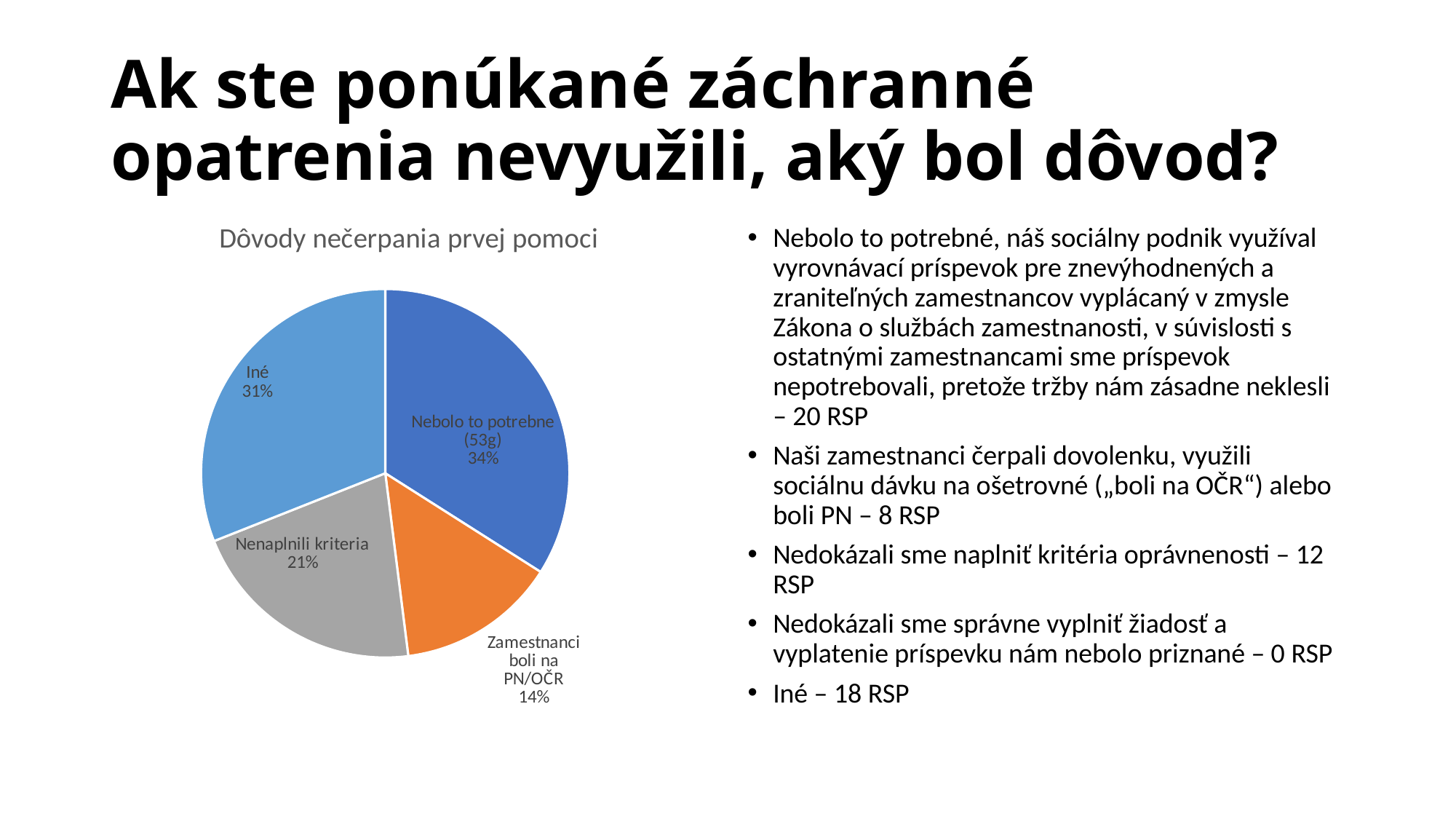
How many slices does the pie chart have? 4 Which slice of the pie chart is the largest? Nebolo to potrebne (53g) What type of chart is shown on the slide? pie chart What percentage is shown for the slice 'Nenaplnili kriteria'? 21% Which slice of the pie chart is the smallest? Zamestnanci boli na PN/OČR What is the difference in percentage points between the 'Iné' slice and the 'Nenaplnili kriteria' slice? 10 Which slice is larger: 'Iné' or 'Nenaplnili kriteria'? Iné What percentage is shown for the slice 'Zamestnanci boli na PN/OČR'? 14% What share of the pie does the slice 'Nebolo to potrebne (53g)' represent? 34% What percentage is shown for the slice 'Iné'? 31% What colour is the 'Nenaplnili kriteria' slice? grey What is the title of the chart? Dôvody nečerpania prvej pomoci